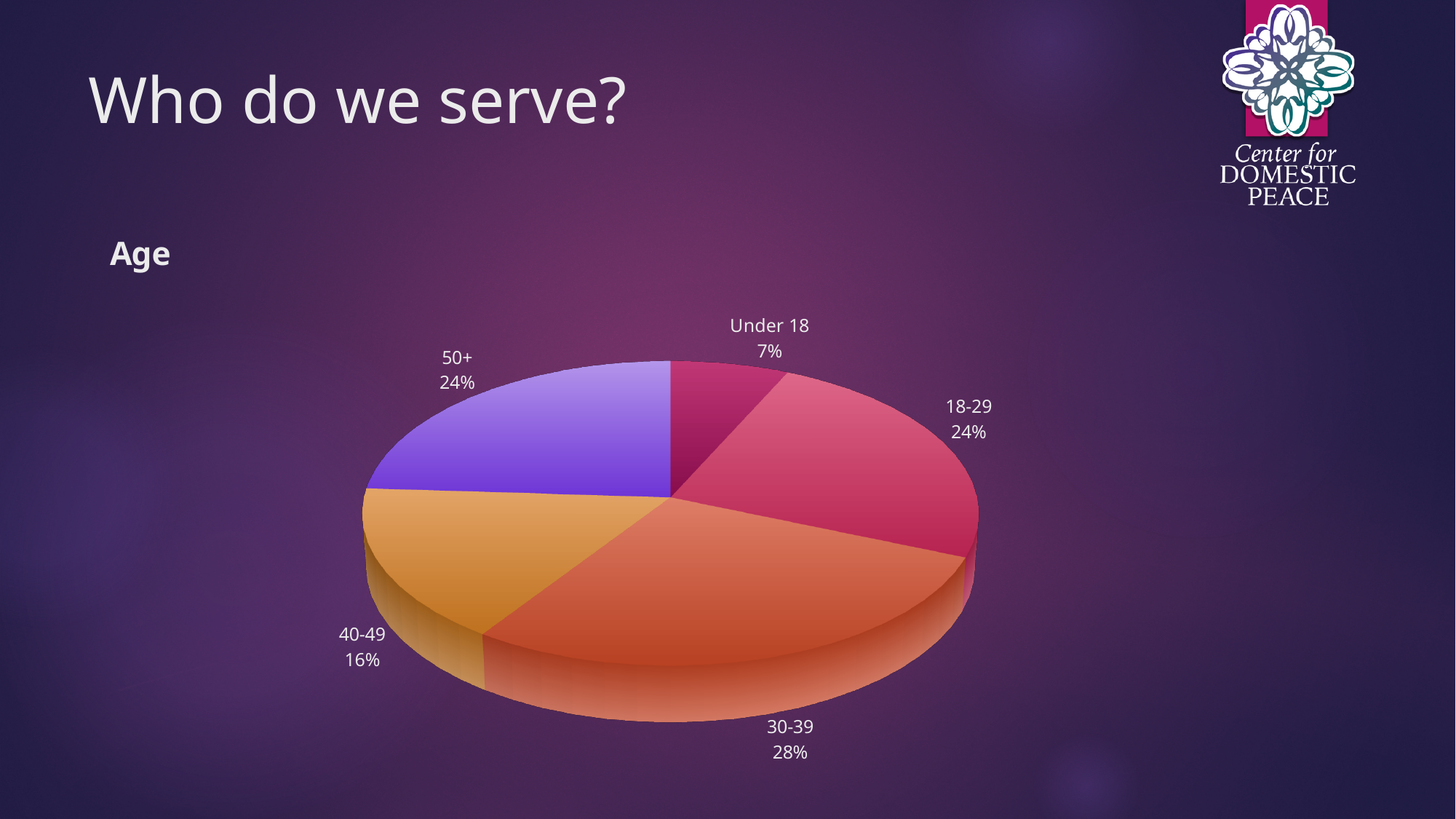
What percentage of those served are aged 50+? 24% What percentage of those served are aged 30-39? 28% What is the label above the pie chart? Age What percentage of those served are aged 40-49? 16% Which age group has the largest share of the pie? 30-39 What type of chart is shown on the slide? Pie chart What is the difference in percentage points between the 30-39 and 40-49 age groups? 12 Which age group has the smallest share of the pie? Under 18 Which is larger, the share for 18-29 or the share for 40-49? 18-29 What percentage of those served are under 18? 7% How many age categories are shown in the pie chart? 5 What is the combined share of the 18-29 and 50+ age groups? 48%